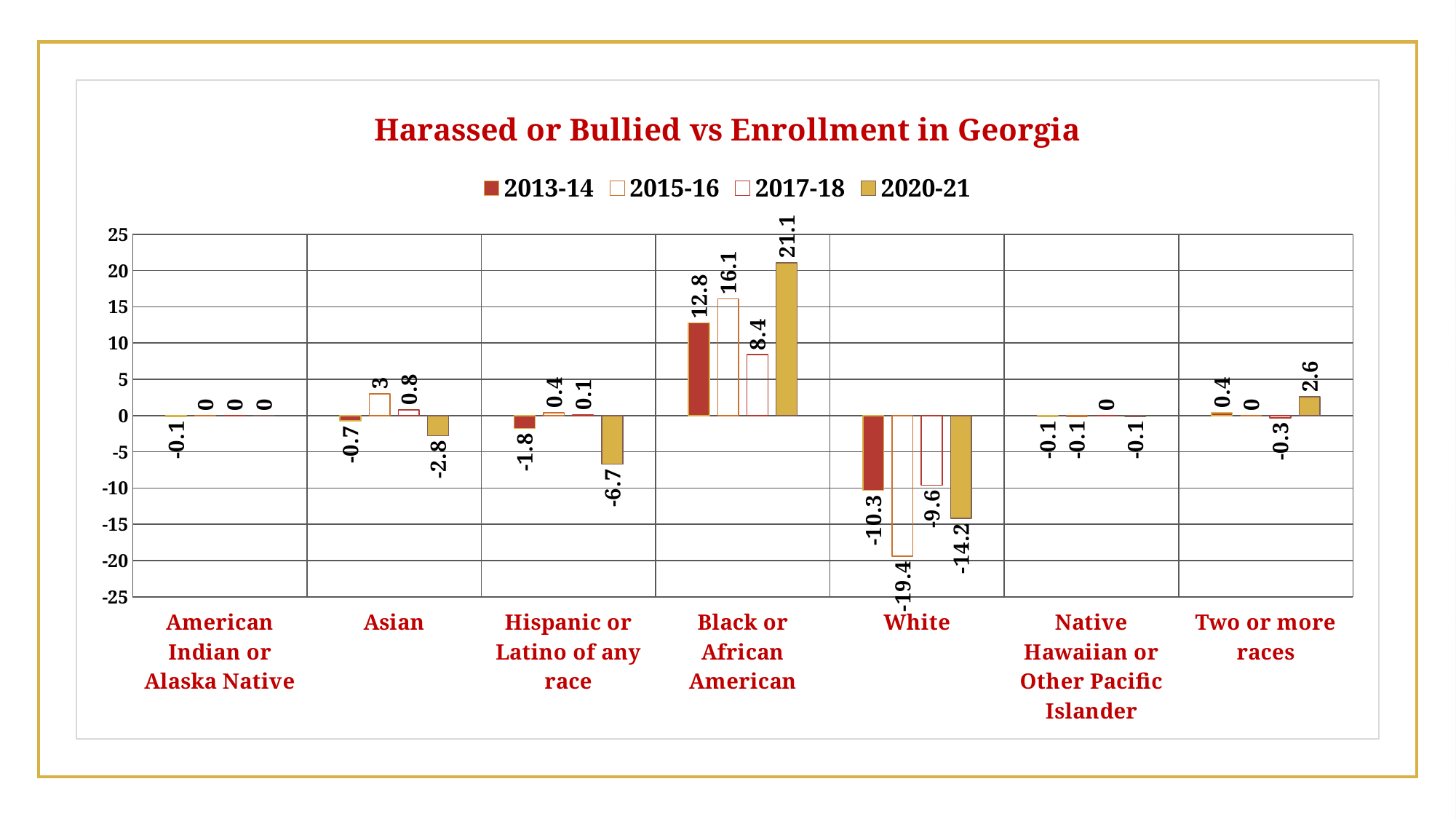
What is the value for White in the 2015-16 series? -19.4 What is the value for Hispanic or Latino of any race in the 2020-21 series? -6.7 What is the value for Black or African American in the 2020-21 series? 21.1 What is the value for Asian in the 2015-16 series? 3 Which category has the highest value in the 2013-14 series? Black or African American What is the difference between the 2020-21 and 2013-14 values for Black or African American? 8.3 How many series does the legend list? 4 Which is larger for Two or more races: the 2013-14 value or the 2020-21 value? 2020-21 What kind of chart is this? Bar chart Which category has the lowest value in the 2020-21 series? White What is the title of the chart? Harassed or Bullied vs Enrollment in Georgia How many categories are shown on the x axis? 7